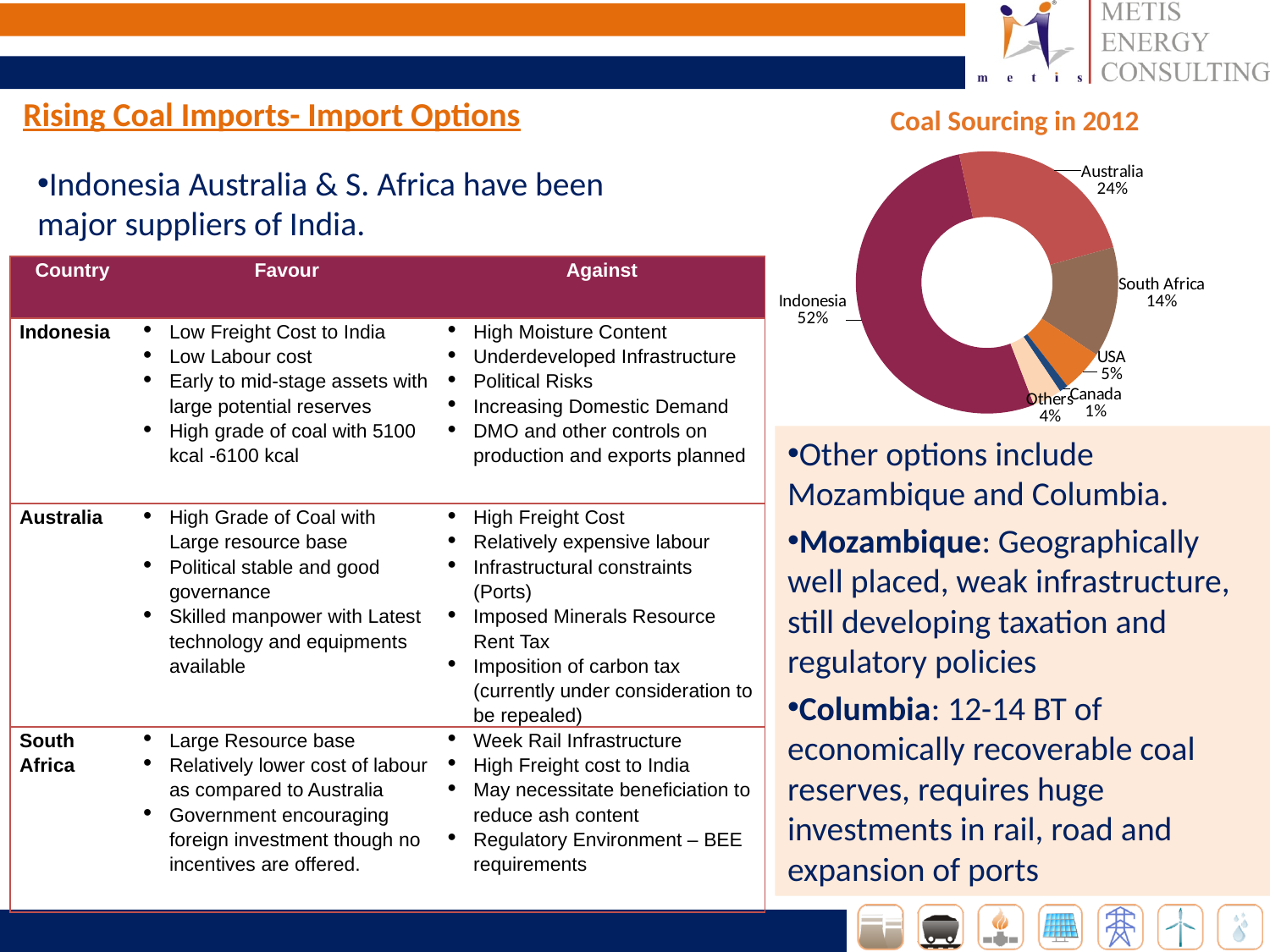
In the Coal Sourcing in 2012 chart, which is larger: the share for South Africa or the share for USA? South Africa What share of coal sourcing in 2012 came from Indonesia? 52% What share of coal sourcing in 2012 came from Australia? 24% What share of coal sourcing in 2012 came from South Africa? 14% Which category has the smallest share in the Coal Sourcing in 2012 chart? Canada How many categories are shown in the Coal Sourcing in 2012 chart? 6 Which country has the largest share in the Coal Sourcing in 2012 chart? Indonesia What kind of chart is shown under the title "Coal Sourcing in 2012"? doughnut chart What share of coal sourcing in 2012 came from Canada? 1% In the Coal Sourcing in 2012 chart, what is the difference in percentage points between Indonesia's and Australia's shares? 28 What share of coal sourcing in 2012 came from the USA? 5% What is the title of the chart on the slide? Coal Sourcing in 2012